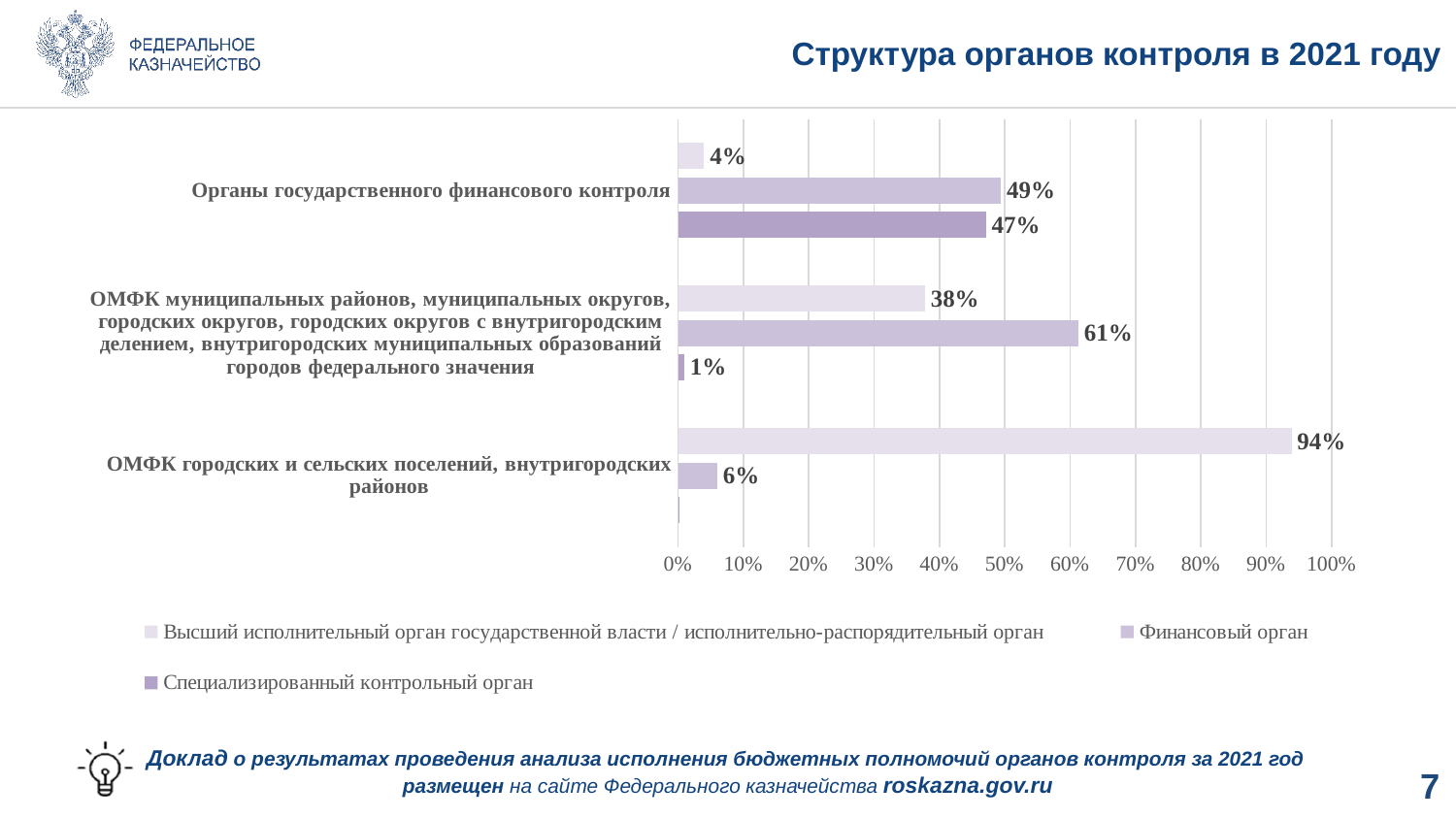
Which category has the lowest value for 'Высший исполнительный орган государственной власти / исполнительно-распорядительный орган'? Органы государственного финансового контроля Which category has the highest value for 'Финансовый орган'? ОМФК муниципальных районов, муниципальных округов, городских округов, городских округов с внутригородским делением, внутригородских муниципальных образований городов федерального значения For 'ОМФК городских и сельских поселений, внутригородских районов', which is larger: 'Высший исполнительный орган' or 'Финансовый орган'? Высший исполнительный орган государственной власти / исполнительно-распорядительный орган What is the title of the chart on the slide? Структура органов контроля в 2021 году What is the difference between the 'Финансовый орган' value (61%) and the 'Высший исполнительный орган' value (38%) for the 'ОМФК муниципальных районов...' category? 23% What is the value of 'Специализированный контрольный орган' for 'Органы государственного финансового контроля'? 47% How many series does the legend list? 3 What kind of chart is shown on the slide? bar chart How many categories are shown on the chart? 3 What is the value of 'Высший исполнительный орган государственной власти / исполнительно-распорядительный орган' for 'ОМФК городских и сельских поселений, внутригородских районов'? 94% What is the value of 'Финансовый орган' for 'Органы государственного финансового контроля'? 49% What is the value of 'Специализированный контрольный орган' for the 'ОМФК муниципальных районов...' category? 1%